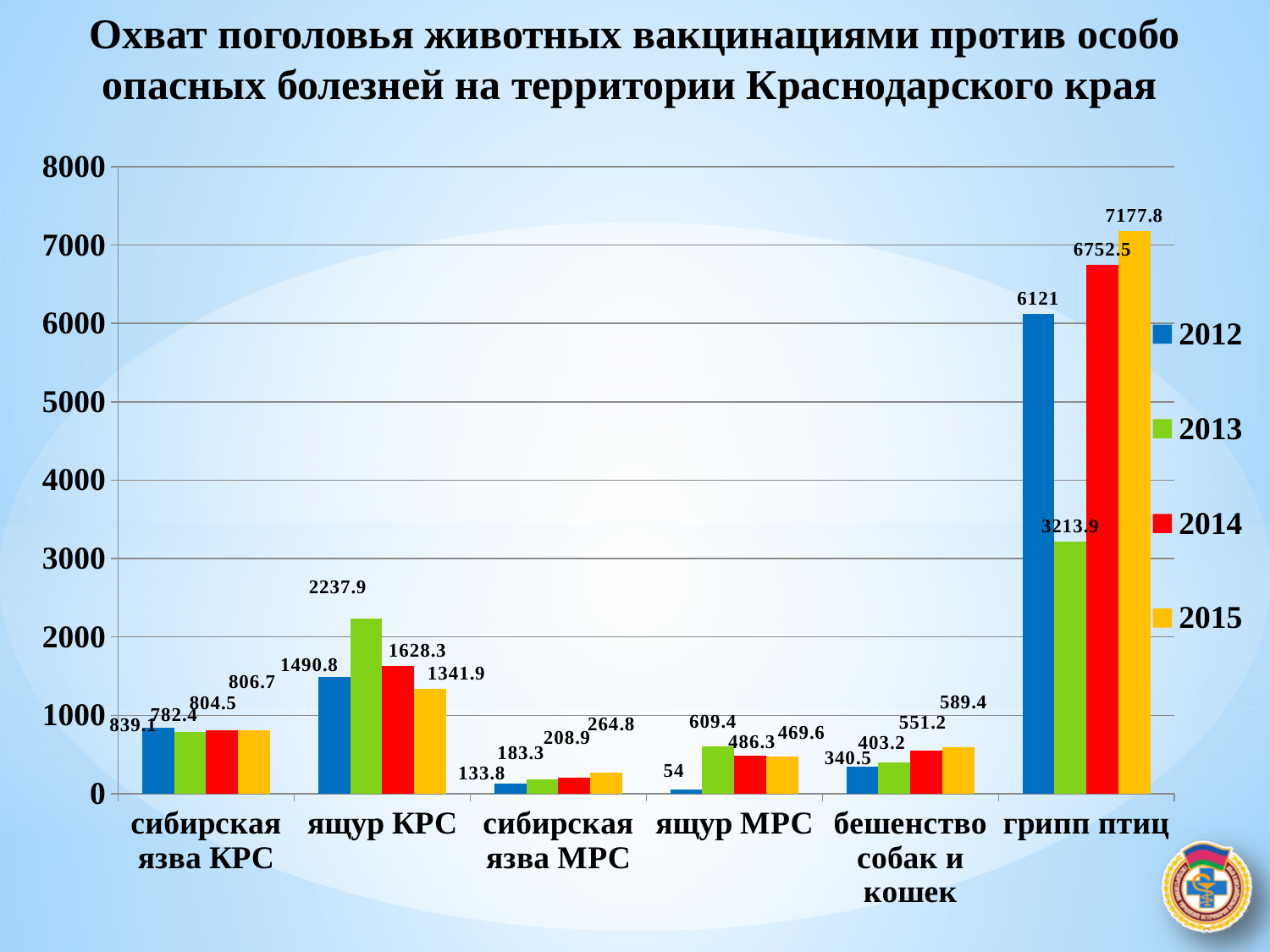
What is the value for грипп птиц in 2015? 7177.8 What is the value for бешенство собак и кошек in 2014? 551.2 Which year has the lowest value for грипп птиц? 2013 How many categories are shown on the x axis? 6 Which category has the highest value in 2015? грипп птиц What is the value for ящур МРС in 2012? 54 Which is larger for сибирская язва МРС: the 2012 value or the 2015 value? 2015 What type of chart is shown on the slide? bar chart What is the value for ящур КРС in 2013? 2237.9 How many series does the legend list? 4 Do the values for сибирская язва МРС rise or fall from 2012 to 2015? rise What is the difference between the 2015 and 2014 values for грипп птиц? 425.3